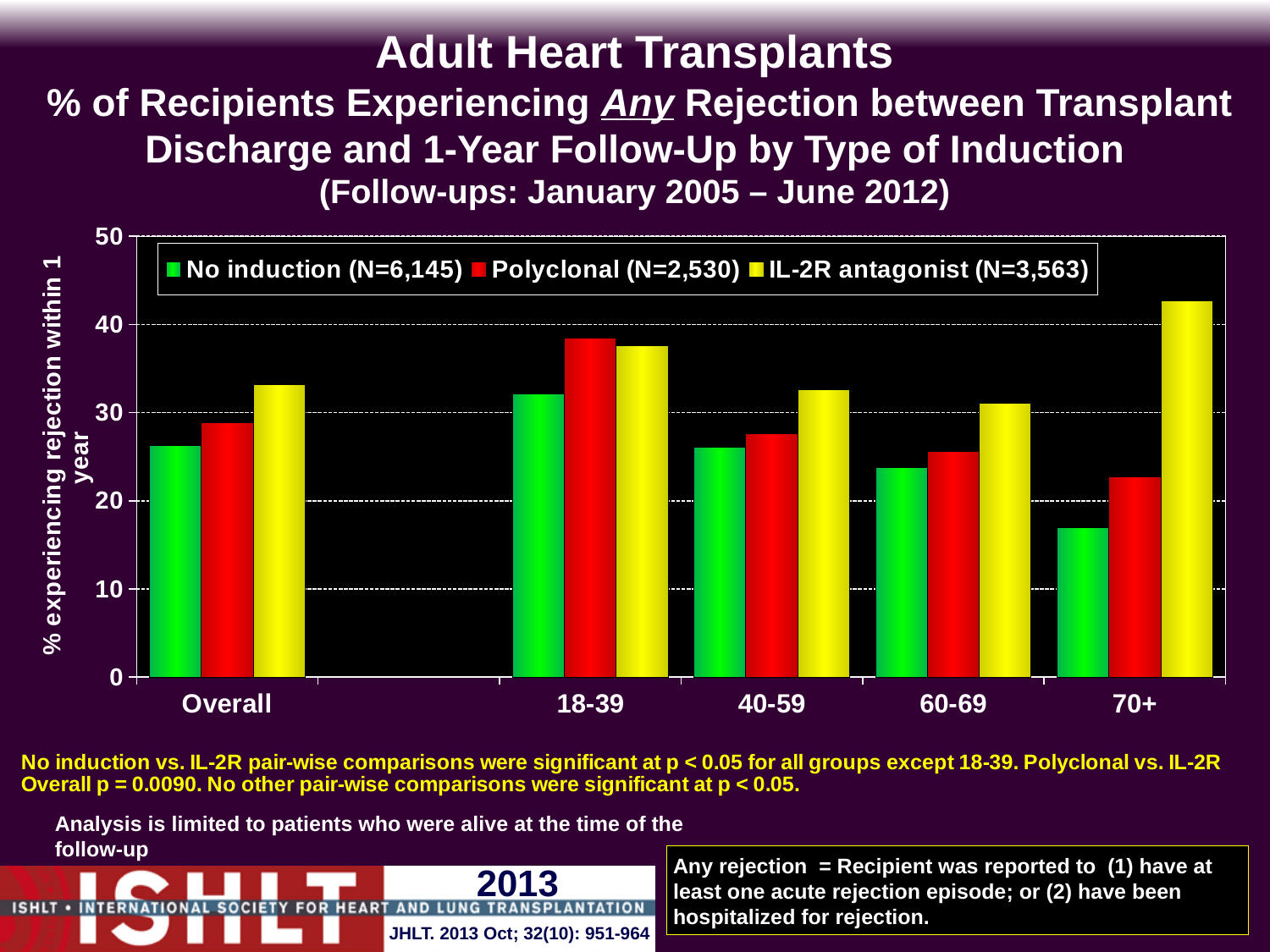
Is the value for IL-2R antagonist in the 70+ group greater or less than 40? greater How many series does the legend list? 3 Is the value for No induction in the 60-69 group greater or less than 30? less Is the value for No induction in the 70+ group greater or less than 20? less Which category and series has the lowest bar in the chart? No induction, 70+ Do the Polyclonal values rise or fall across the age groups from 18-39 to 70+? fall Which is larger: the No induction value for 18-39 or the No induction value for 70+? 18-39 What colour represents the IL-2R antagonist series? yellow Which category and series has the highest bar in the chart? IL-2R antagonist, 70+ What kind of chart is shown on the slide? bar chart How many categories are shown along the x axis? 5